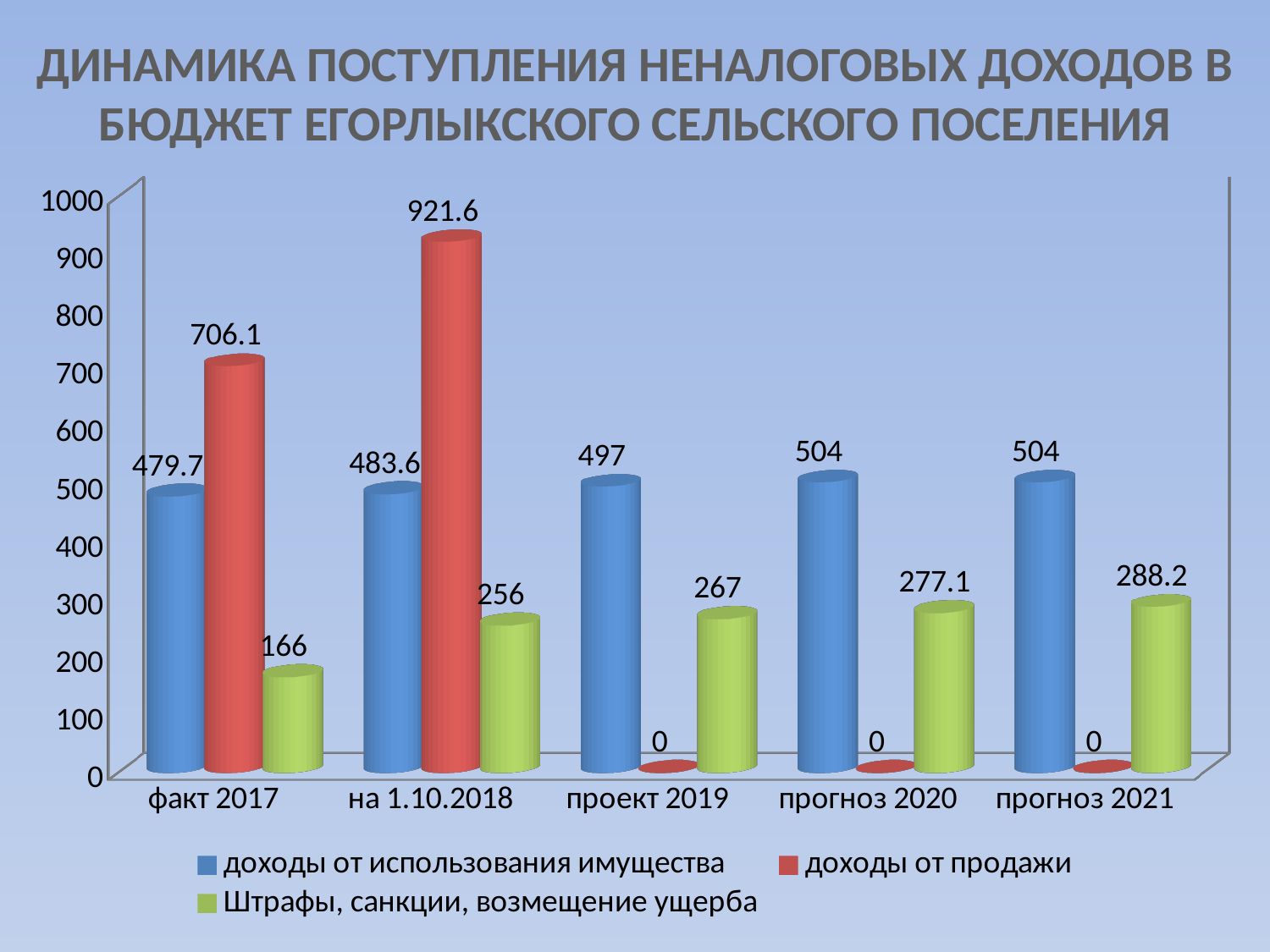
Which is larger: 'доходы от использования имущества' for 'проект 2019' or for 'прогноз 2020'? прогноз 2020 What is the value of 'Штрафы, санкции, возмещение ущерба' for 'прогноз 2021'? 288.2 What is the value of 'доходы от использования имущества' for 'факт 2017'? 479.7 How many series does the legend list? 3 What is the difference between 'доходы от продажи' for 'на 1.10.2018' and for 'факт 2017'? 215.5 What is the value of 'доходы от продажи' for 'на 1.10.2018'? 921.6 What kind of chart is shown on the slide? bar chart Which category has the lowest value for 'Штрафы, санкции, возмещение ущерба'? факт 2017 Which category has the highest value for 'доходы от продажи'? на 1.10.2018 What is the value of 'доходы от продажи' for 'проект 2019'? 0 Do the values for 'Штрафы, санкции, возмещение ущерба' rise or fall from 'факт 2017' to 'прогноз 2021'? rise How many categories are shown on the x axis? 5